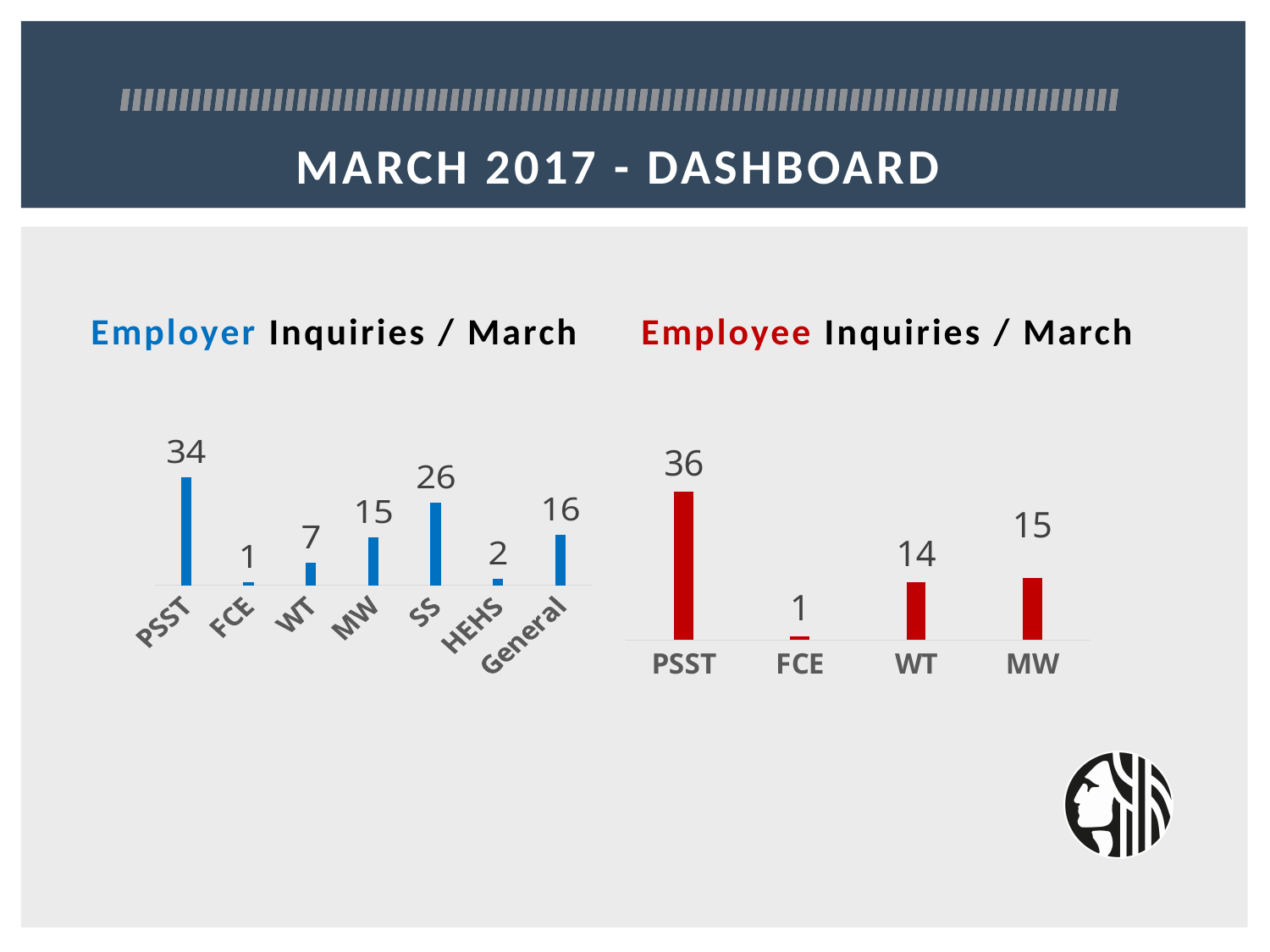
In the Employer Inquiries / March chart, what is the value for PSST? 34 In the Employer Inquiries / March chart, which is larger, MW or General? General What kind of chart is the Employee Inquiries / March chart? Bar chart In the Employee Inquiries / March chart, which category has the highest value? PSST What colour are the bars in the Employer Inquiries / March chart? Blue In the Employer Inquiries / March chart, how many categories are shown? 7 In the Employee Inquiries / March chart, what is the difference between PSST and MW? 21 In the Employer Inquiries / March chart, what is the value for SS? 26 In the Employer Inquiries / March chart, which category has the lowest value? FCE In the Employee Inquiries / March chart, how many categories are shown? 4 In the Employer Inquiries / March chart, what is the difference between PSST and SS? 8 In the Employee Inquiries / March chart, what is the value for WT? 14